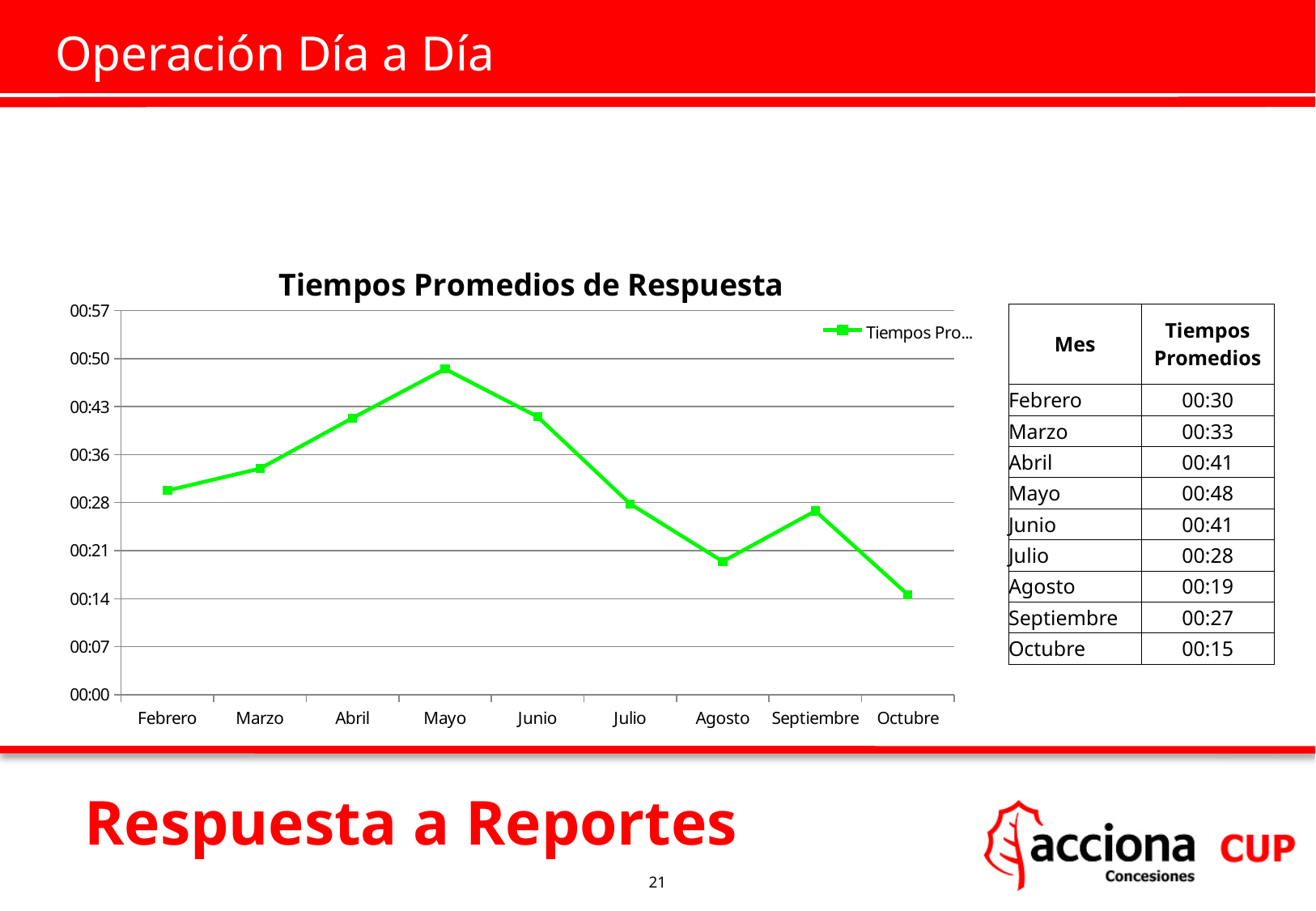
Which month has the highest value in the Tiempos Promedios de Respuesta chart? Mayo What is the value for Agosto in the Tiempos Promedios de Respuesta chart? 00:19 What is the value for Mayo in the Tiempos Promedios de Respuesta chart? 00:48 What is the value for Septiembre in the Tiempos Promedios de Respuesta chart? 00:27 Which is larger in the Tiempos Promedios de Respuesta chart, the value for Febrero or the value for Julio? Febrero How many months are plotted on the x axis of the Tiempos Promedios de Respuesta chart? 9 Do the values in the Tiempos Promedios de Respuesta chart rise or fall from Mayo to Agosto? fall What kind of chart is the Tiempos Promedios de Respuesta chart? line chart Is the value for Mayo in the Tiempos Promedios de Respuesta chart greater or less than 00:43? greater How many series does the legend of the Tiempos Promedios de Respuesta chart list? 1 What is the difference between the values for Mayo and Octubre in the Tiempos Promedios de Respuesta chart? 00:33 Which month has the lowest value in the Tiempos Promedios de Respuesta chart? Octubre